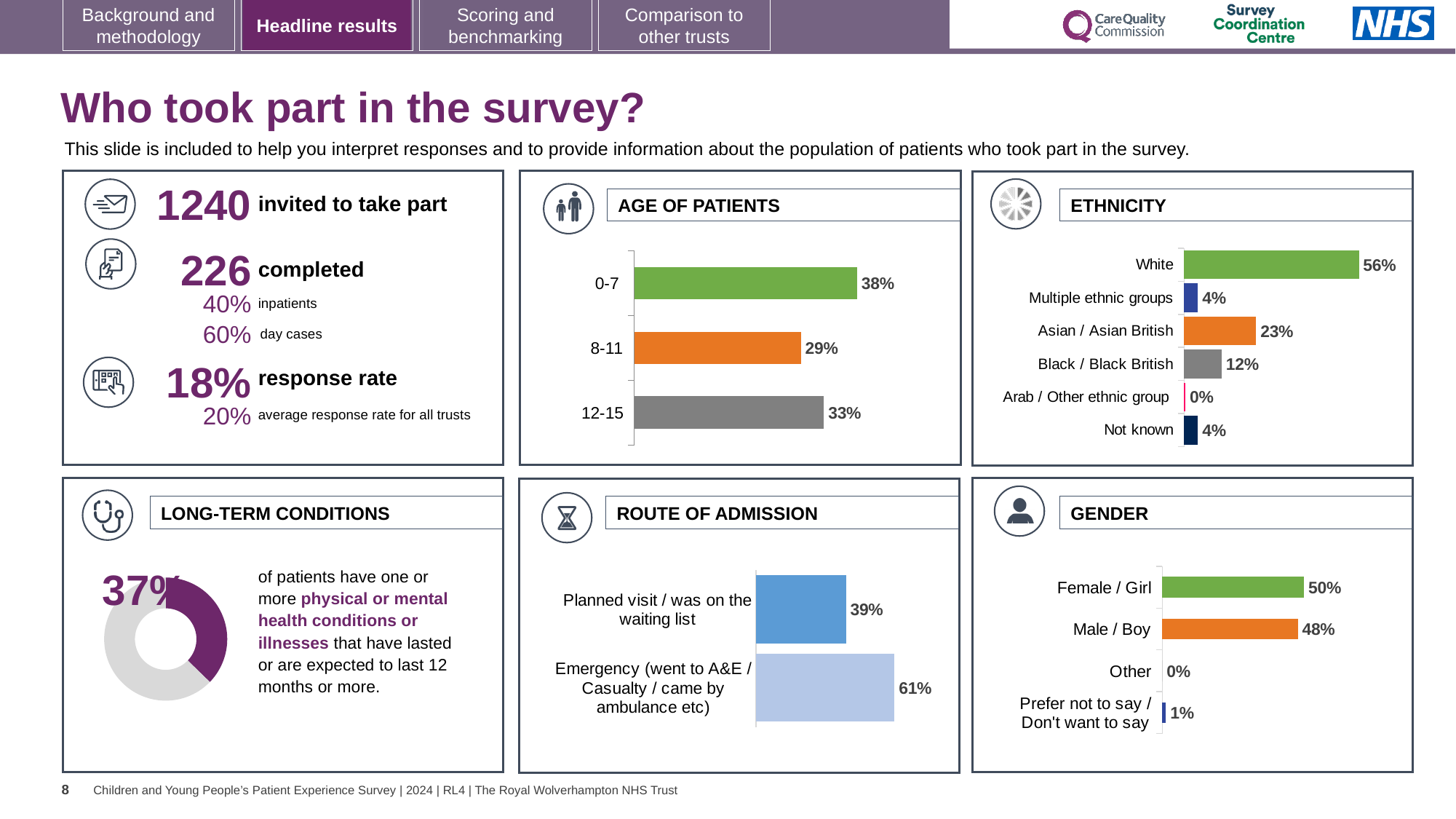
In the GENDER chart, what percentage of patients were Male / Boy? 48% In the ROUTE OF ADMISSION chart, what percentage of patients came via Emergency (went to A&E / Casualty / came by ambulance etc)? 61% In the AGE OF PATIENTS chart, what is the difference between the 0-7 and 12-15 percentages? 5% In the ETHNICITY chart, what percentage of patients were Asian / Asian British? 23% In the AGE OF PATIENTS chart, what percentage of patients were aged 0-7? 38% In the AGE OF PATIENTS chart, which age group has the lowest percentage? 8-11 In the ETHNICITY chart, which is larger: Black / Black British or Multiple ethnic groups? Black / Black British In the ROUTE OF ADMISSION chart, what is the difference between the Emergency and Planned visit percentages? 22% In the ETHNICITY chart, which category has the highest percentage? White In the GENDER chart, what is the total of the Female / Girl and Male / Boy percentages? 98% What kind of chart is used in the LONG-TERM CONDITIONS panel? Doughnut chart How many categories are shown in the ETHNICITY chart? 6